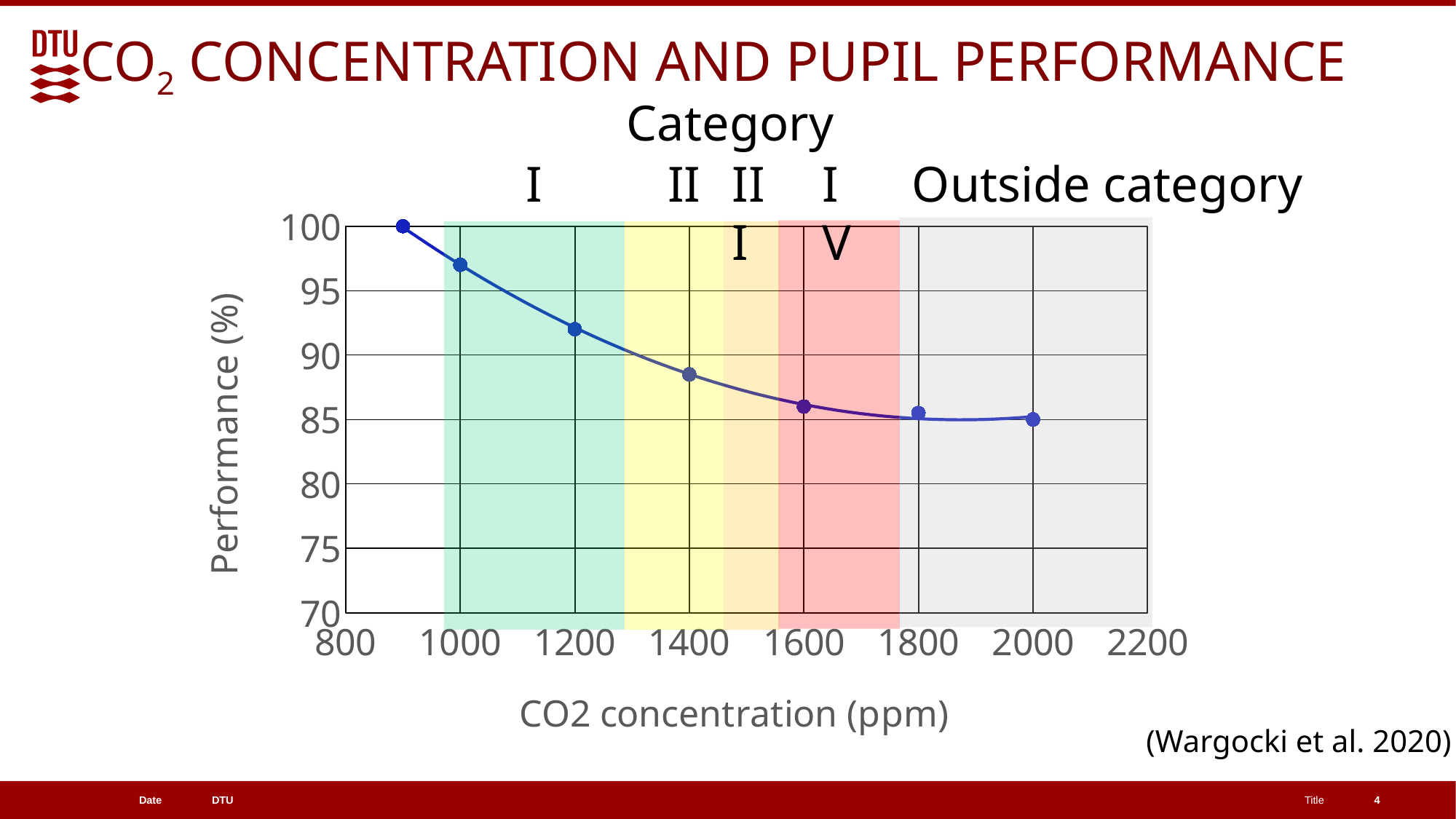
What kind of chart is shown on the slide? Line chart with markers At which CO2 concentration is performance highest? 900 ppm Is the performance value at 1400 ppm greater or less than 90? less How many data points are plotted on the chart? 7 Is the performance value at 2000 ppm greater or less than 90? less What is the label of the x axis? CO2 concentration (ppm) Which has the higher performance value: 1200 ppm or 1600 ppm? 1200 ppm What is the performance value at a CO2 concentration of 900 ppm? 100 Is the performance value at 1200 ppm greater or less than 90? greater Does performance rise or fall as CO2 concentration increases along the x axis? Fall What is the label of the y axis? Performance (%)